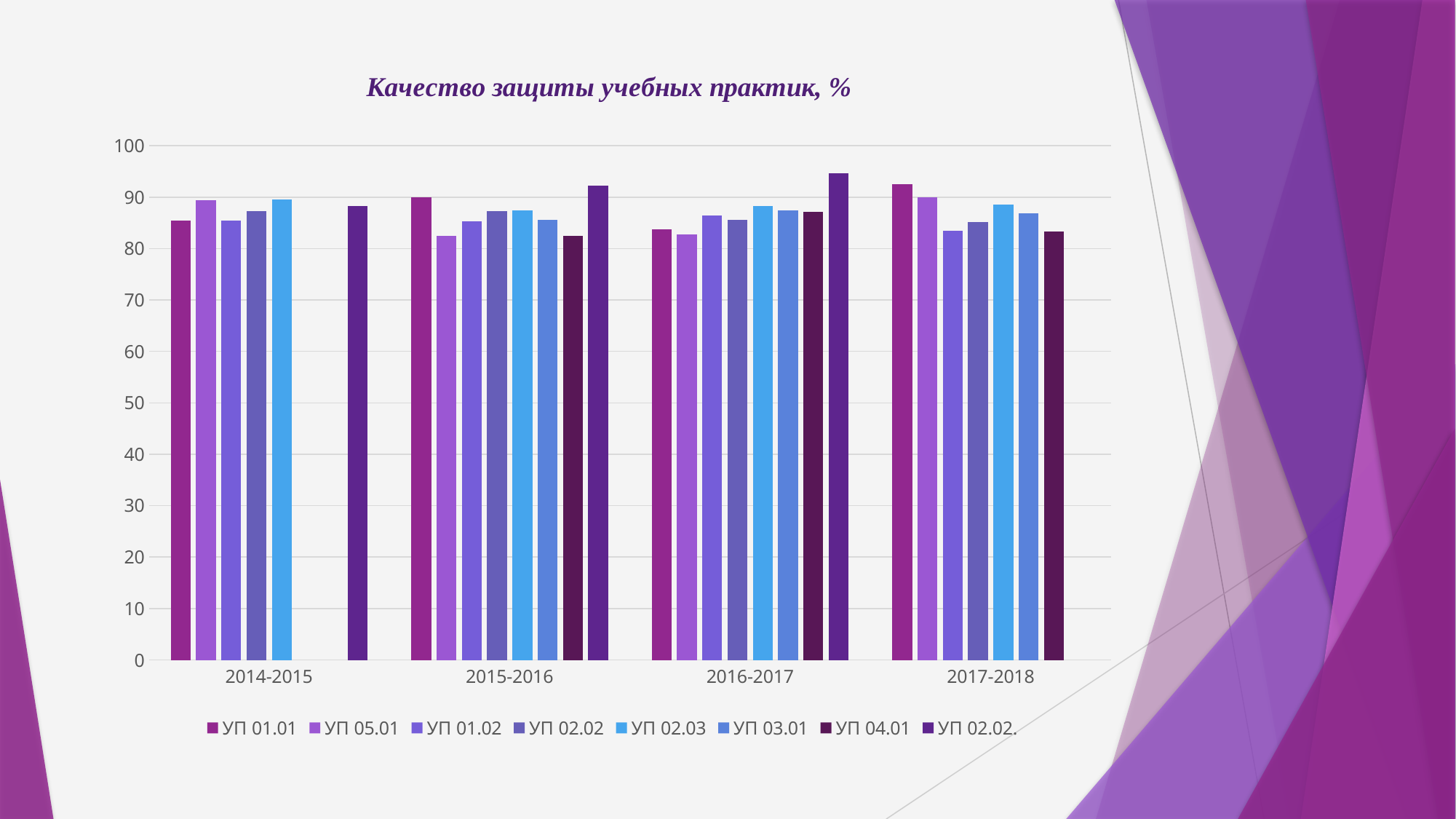
Is the value for УП 01.01 in 2017-2018 greater or less than 90? greater How many series does the legend list? 8 In 2015-2016, which is larger: the value for УП 01.01 or the value for УП 05.01? УП 01.01 What is the title of the chart? Качество защиты учебных практик, % What type of chart is shown on the slide? Bar chart Is the value for УП 05.01 in 2016-2017 greater or less than 80? greater Is the value for УП 04.01 in 2015-2016 greater or less than 90? less Which series has the highest value in 2017-2018? УП 01.01 Does the value for УП 02.02. rise or fall from 2014-2015 to 2016-2017? rise How many academic-year categories are shown on the x axis? 4 Which series has the highest value in 2016-2017? УП 02.02.